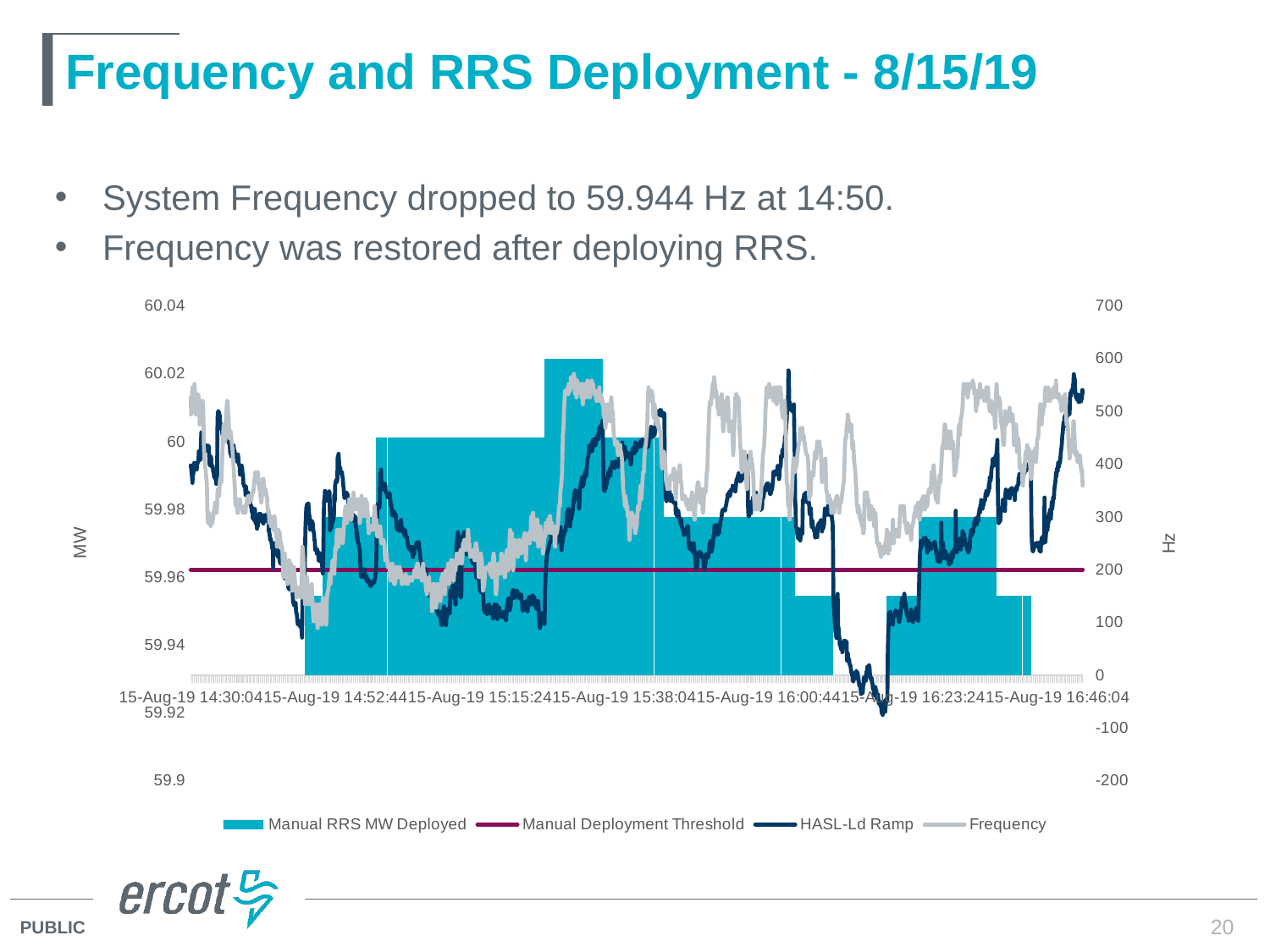
How many series does the chart legend list? 4 Is the tallest Manual RRS MW Deployed bar greater or less than 500 on the right axis? greater Is the Manual RRS MW Deployed bar between 14:52:44 and 15:15:24 greater or less than 400 on the right axis? greater What is the lowest tick value shown on the right-hand axis of the chart? -200 How many time labels are shown along the x axis of the chart? 7 What is the highest tick value shown on the right-hand axis of the chart? 700 Is the Manual Deployment Threshold line greater or less than 300 on the right axis? less What are the labels of the left and right vertical axes of the chart? MW (left) and Hz (right) What kind of chart is shown on the slide? A combination bar and line chart Which series is drawn as bars in the chart? Manual RRS MW Deployed What is the highest tick value shown on the left-hand axis of the chart? 60.04